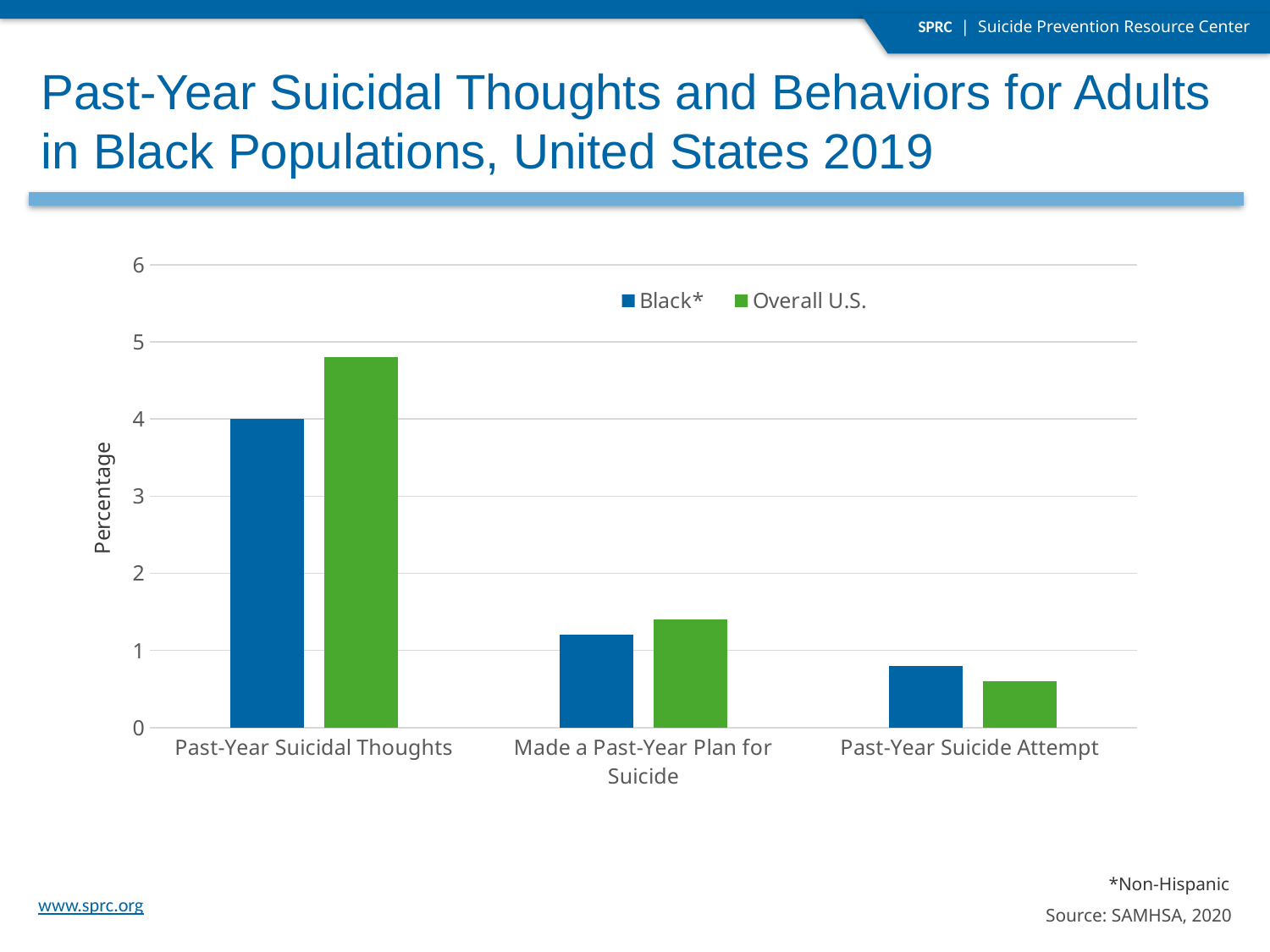
Which category has the lowest value for the Overall U.S. series? Past-Year Suicide Attempt Is the Overall U.S. value for Past-Year Suicide Attempt greater or less than 1? less Is the Black* value for Made a Past-Year Plan for Suicide greater or less than 2? less What is the Black* value for Past-Year Suicidal Thoughts? 4 How many categories are shown on the x axis? 3 For Past-Year Suicidal Thoughts, which series has the larger value, Black* or Overall U.S.? Overall U.S. For Past-Year Suicide Attempt, which series has the larger value, Black* or Overall U.S.? Black* What kind of chart is shown on the slide? Bar chart What is the title of the y axis? Percentage Is the Overall U.S. value for Past-Year Suicidal Thoughts greater or less than 4? greater How many series does the legend list? 2 Which category has the highest value for the Black* series? Past-Year Suicidal Thoughts